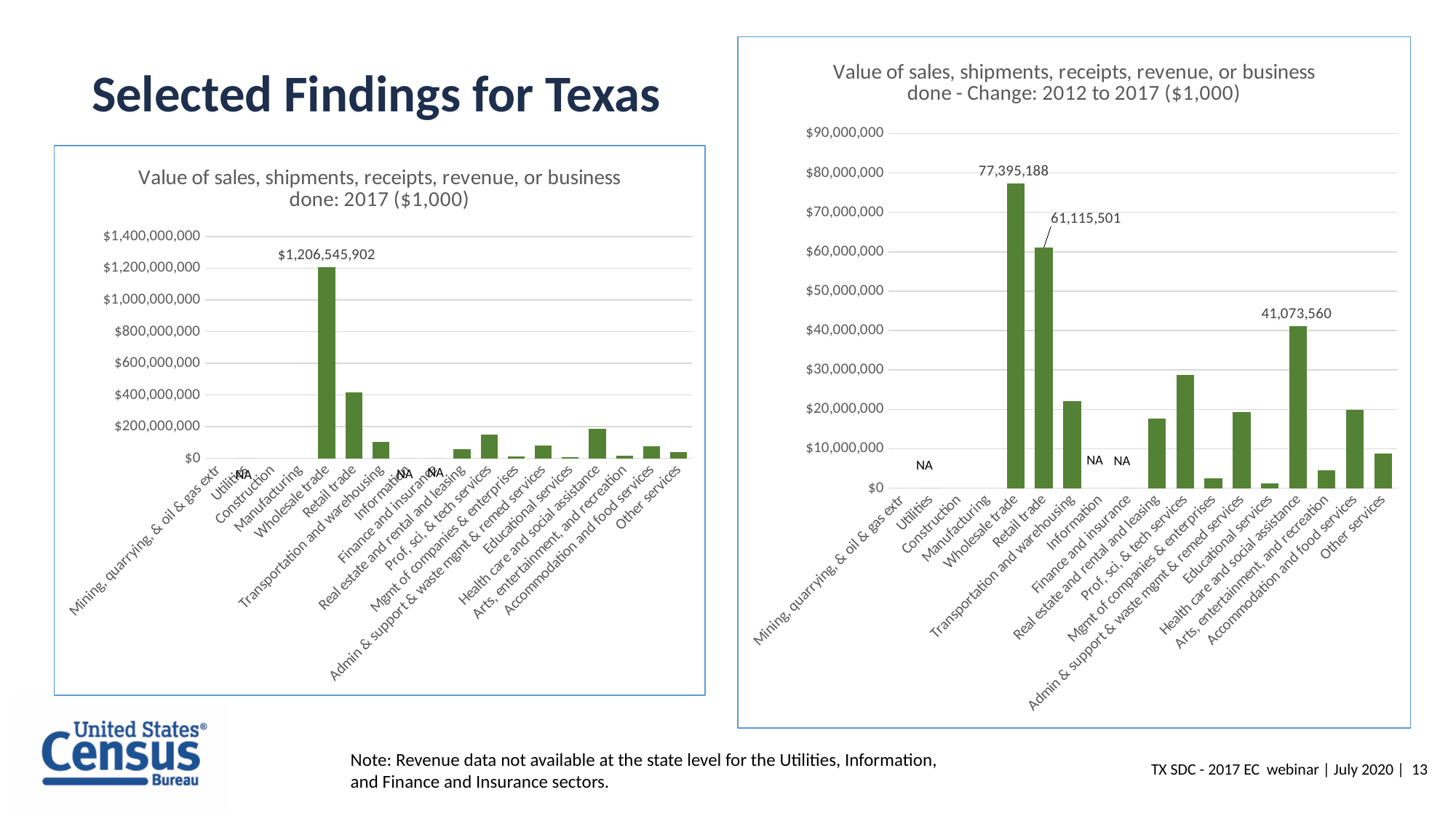
In the right chart (Change: 2012 to 2017), what is the value for Retail trade? 61,115,501 In the right chart (Change: 2012 to 2017), what is the value for Health care and social assistance? 41,073,560 In the left chart (2017 values), what is the value for Wholesale trade? $1,206,545,902 In the right chart (Change: 2012 to 2017), what is the value for Wholesale trade? 77,395,188 How many sector categories are listed on the x axis of the right chart? 18 In the left chart (2017 values), which is larger: Retail trade or Transportation and warehousing? Retail trade In the right chart (Change: 2012 to 2017), which is larger: Educational services or Other services? Other services In the right chart (Change: 2012 to 2017), what is the difference between Wholesale trade and Retail trade? 16,279,687 In the left chart (2017 values), which sector has the highest value? Wholesale trade What type of chart is the left chart? Bar chart In the left chart (2017 values), is the value for Retail trade greater or less than $600,000,000? less In the right chart (Change: 2012 to 2017), is the value for Prof, sci, & tech services greater or less than $20,000,000? greater